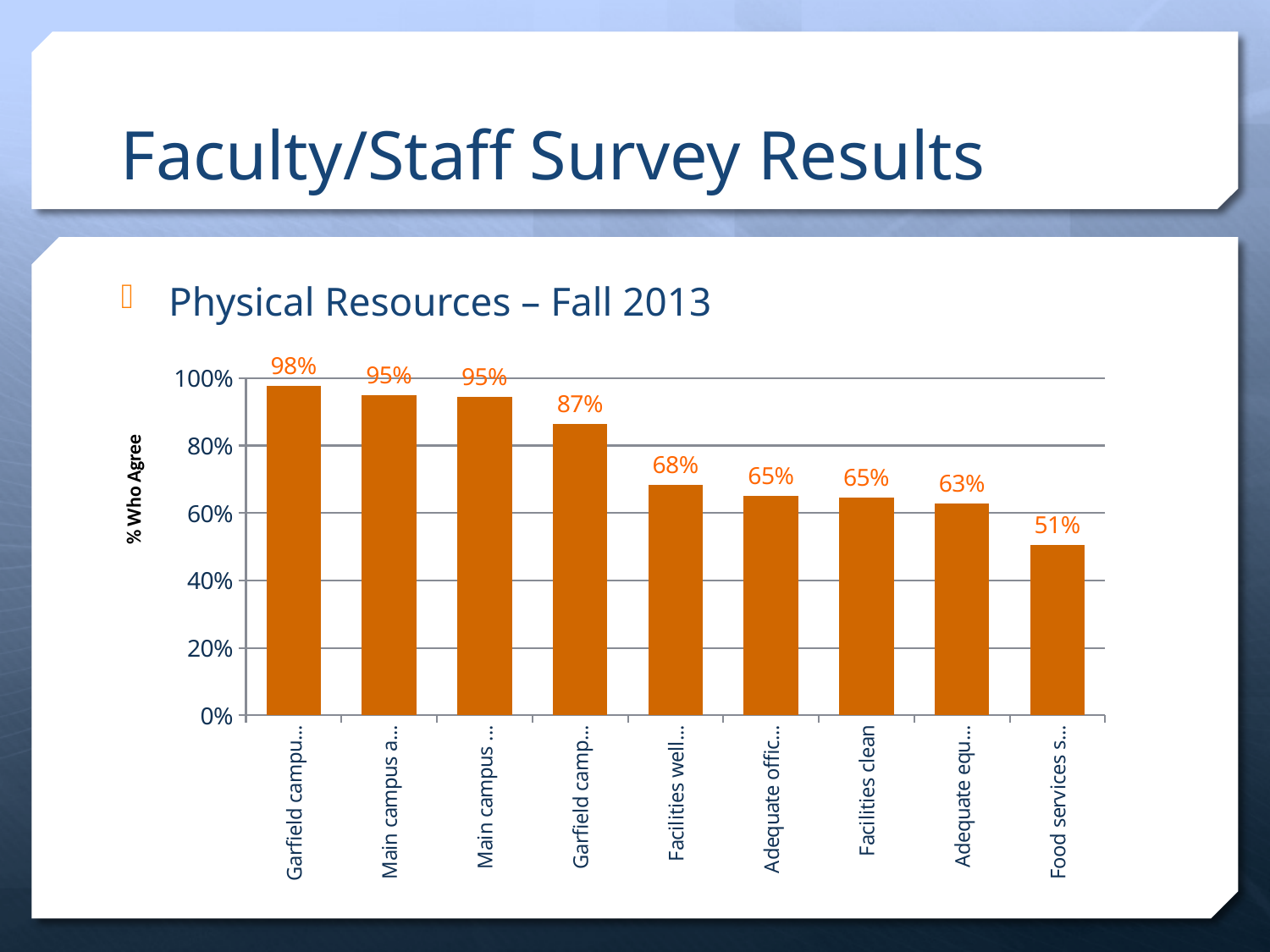
What is the difference between the highest value (98%) and the lowest value (51%)? 47 percentage points Do the bar values generally rise or fall from left to right across the chart? fall What is the value of the last (rightmost) bar, labelled "Food services s..."? 51% What is the lowest value shown in the chart? 51% What kind of chart is shown on the slide? bar chart What is the highest value shown in the chart? 98% How many bars are plotted in the chart? 9 What is the label of the vertical axis? % Who Agree What is the value of the first (leftmost) bar in the chart? 98% Which is larger: the value for "Facilities clean" or the value of the rightmost bar? Facilities clean What is the value for "Facilities clean"? 65% What is the difference between the value for "Facilities clean" and the value of the fourth bar (87%)? 22 percentage points